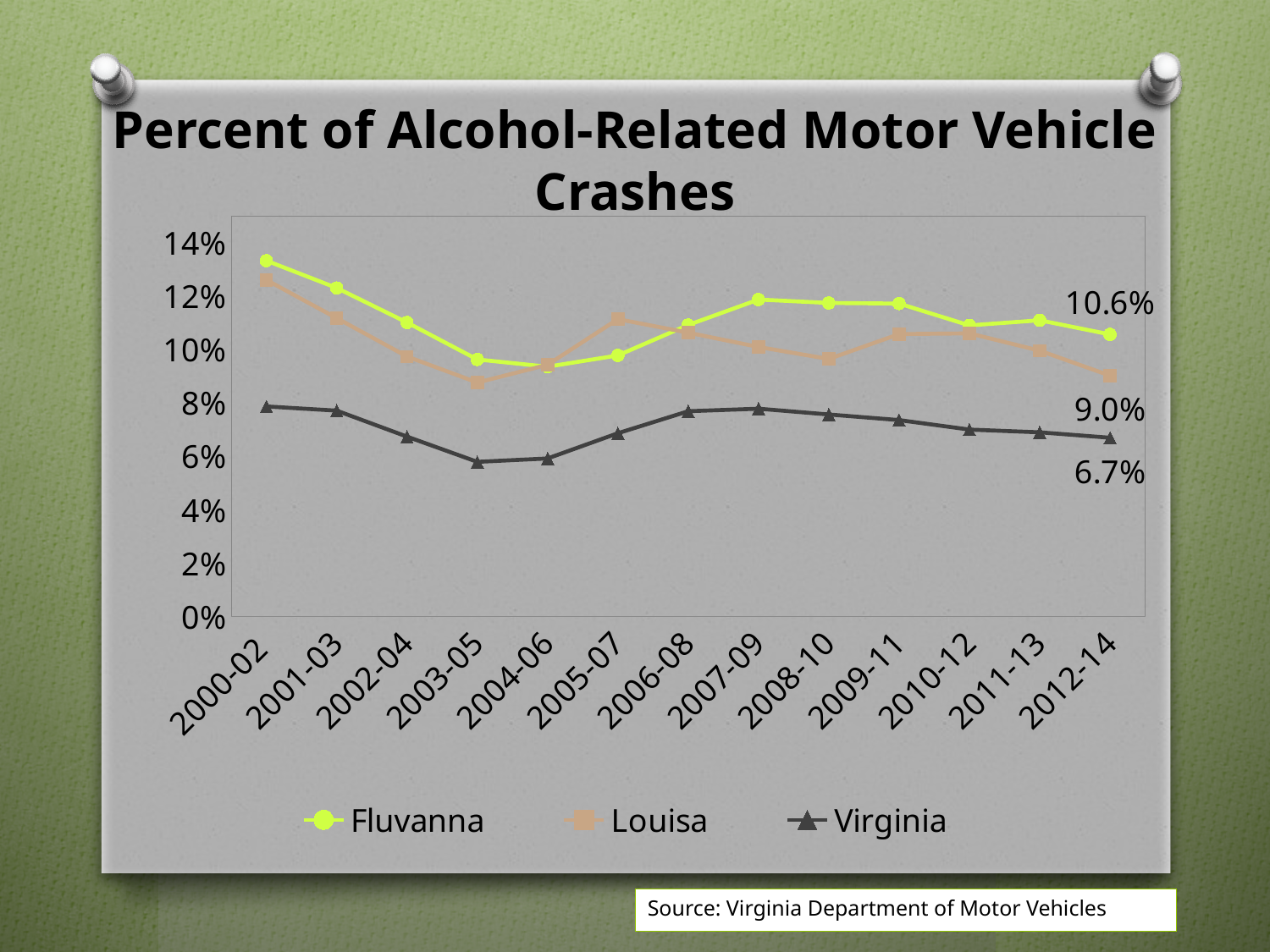
Is the value for Fluvanna in 2000-02 greater or less than 12%? greater What is the value for Louisa in 2012-14? 9.0% Is the value for Louisa in 2003-05 greater or less than 10%? less Which series has the highest value in 2012-14? Fluvanna Which series has the lowest value in 2012-14? Virginia What is the value for Fluvanna in 2012-14? 10.6% Which is larger in 2012-14, the value for Fluvanna or the value for Louisa? Fluvanna How many series does the legend list? 3 How many time periods are shown on the x axis? 13 What is the difference between the Fluvanna and Virginia values in 2012-14? 3.9 percentage points What is the value for Virginia in 2012-14? 6.7% What kind of chart is shown on the slide? Line chart